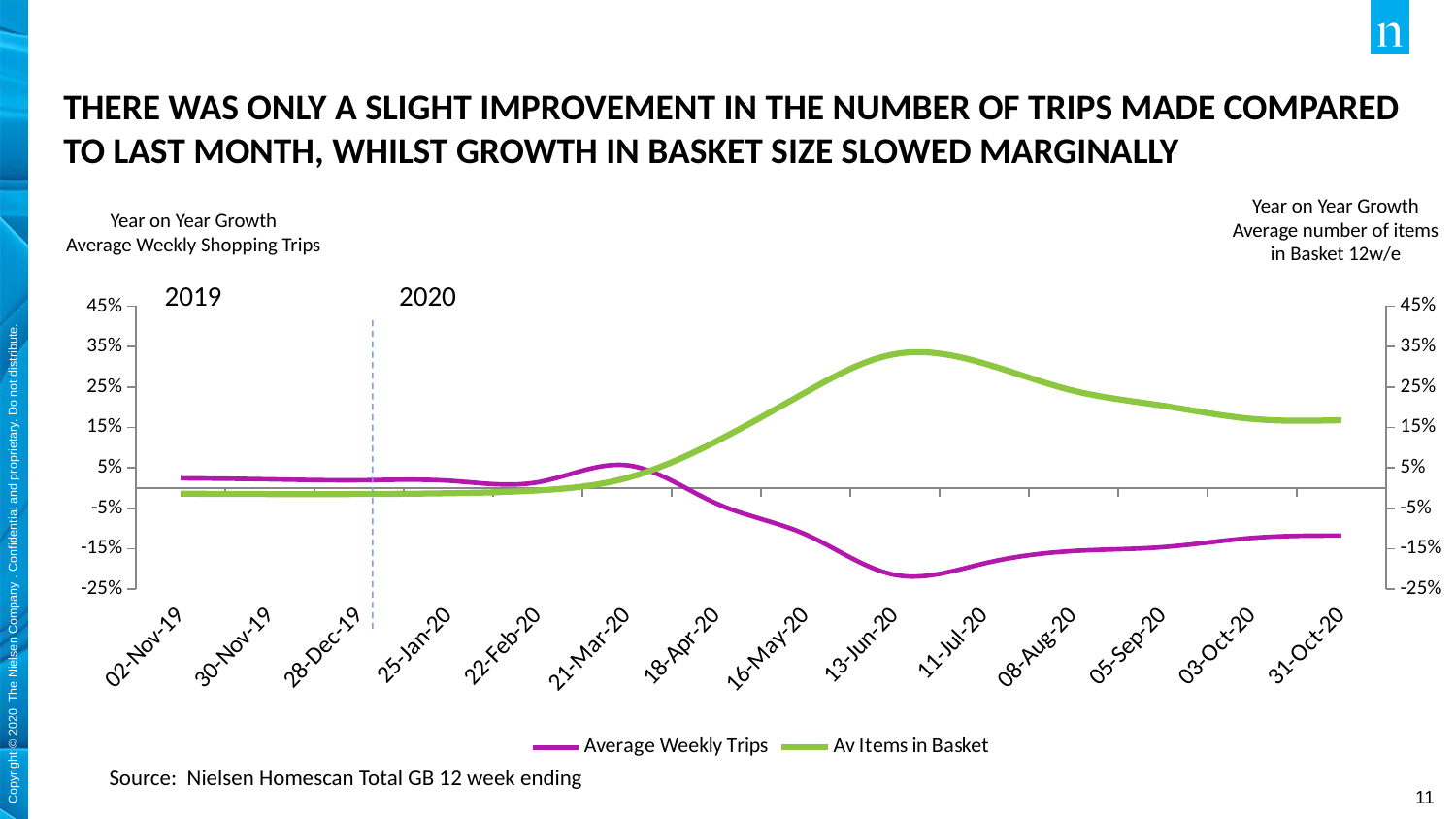
How many series does the legend list? 2 Is the value for Average Weekly Trips at 13-Jun-20 greater or less than -15%? less At 31-Oct-20, which series has the higher value, Average Weekly Trips or Av Items in Basket? Av Items in Basket What kind of chart is shown on the slide? line chart How many date labels are shown along the x axis? 14 At 02-Nov-19, which series has the higher value, Average Weekly Trips or Av Items in Basket? Average Weekly Trips Is the value for Av Items in Basket at 31-Oct-20 greater or less than 5%? greater Around which date does the Av Items in Basket line reach its highest point? 13-Jun-20 Is the value for Av Items in Basket at 13-Jun-20 greater or less than 25%? greater What colour is the Av Items in Basket line? green Does the Average Weekly Trips line rise or fall between 21-Mar-20 and 13-Jun-20? fall